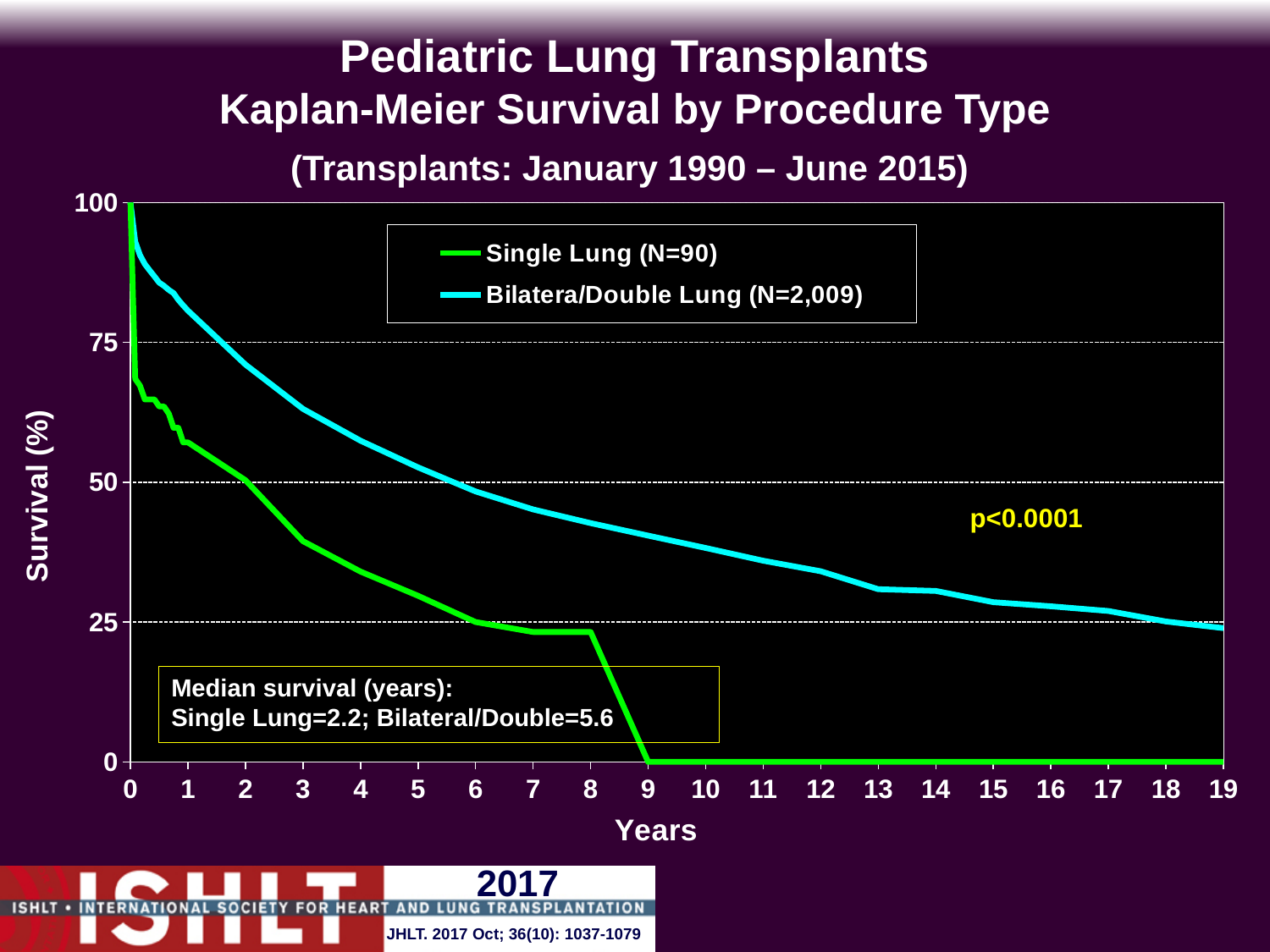
Is the survival for Bilateral/Double Lung at 10 years greater or less than 50? less Is the survival for Bilateral/Double Lung at 15 years greater or less than 25? greater What is the difference in median survival (years) between Bilateral/Double and Single Lung? 3.4 Is the survival for Single Lung at 3 years greater or less than 50? less What is the median survival in years for Bilateral/Double according to the text box? 5.6 What kind of chart is shown on the slide? line chart How many series does the legend list? 2 Which series has the higher survival at 5 years, Single Lung or Bilateral/Double Lung? Bilateral/Double Lung What is the median survival in years for Single Lung according to the text box? 2.2 Do the survival curves rise or fall as years increase along the x axis? fall What is the N for the Bilateral/Double Lung series shown in the legend? 2,009